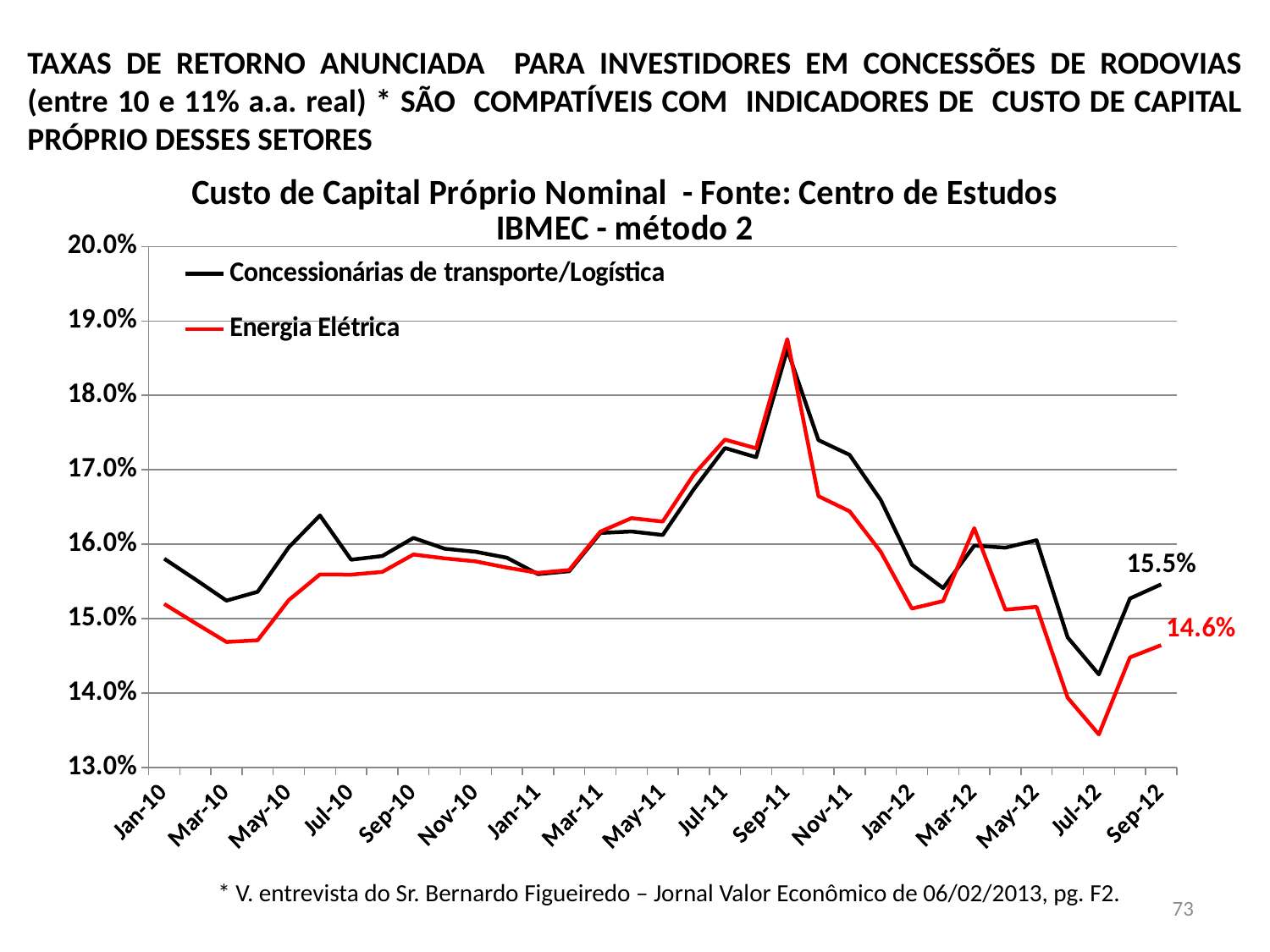
Is the peak value of Energia Elétrica at Sep-11 greater or less than 18.0%? greater Is the value for Energia Elétrica at Jul-12 greater or less than 14.0%? less Is the value for Concessionárias de transporte/Logística at Jan-10 greater or less than 15.0%? greater What is the value labelled for Concessionárias de transporte/Logística at Sep-12? 15.5% What kind of chart is shown on the slide? line chart In which month does the Energia Elétrica series reach its lowest value? Jul-12 How many series does the chart legend list? 2 What is the difference between the Sep-12 values of Concessionárias de transporte/Logística (15.5%) and Energia Elétrica (14.6%)? 0.9 percentage points At Sep-12, which series has the higher value: Concessionárias de transporte/Logística or Energia Elétrica? Concessionárias de transporte/Logística What colour is the line for Energia Elétrica? red What is the value labelled for Energia Elétrica at Sep-12? 14.6% In which month do both series reach their highest value? Sep-11